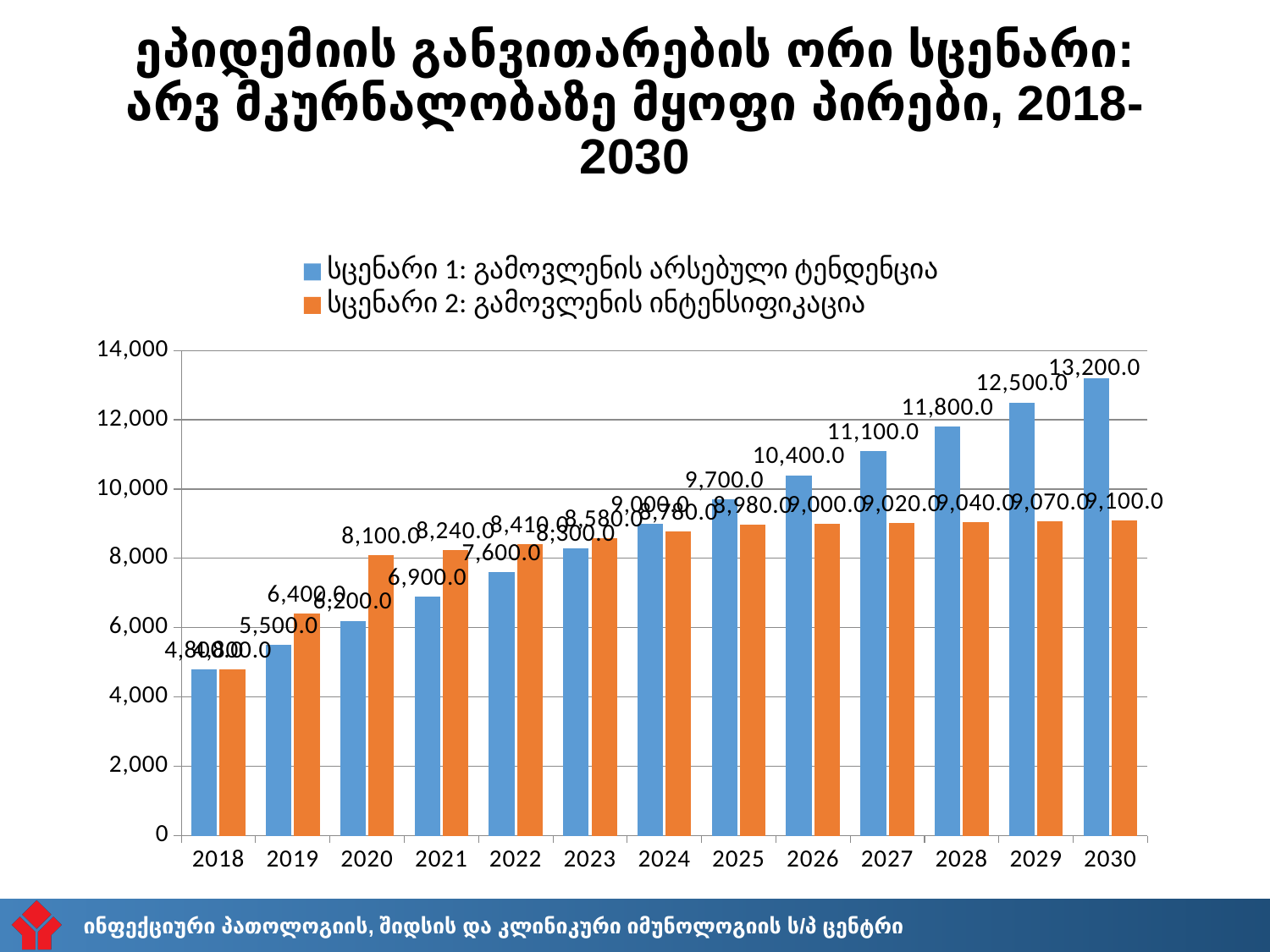
What type of chart is shown on the slide? bar chart Do the values for სცენარი 1 rise or fall from 2018 to 2030? rise How many years are shown on the x axis? 13 What is the value for სცენარი 2 (Scenario 2) in 2020? 8,100.0 Is the value for სცენარი 1 in 2028 greater or less than 10,000? greater How many series does the legend list? 2 In which year does სცენარი 1 (Scenario 1) reach its highest value? 2030 What is the value for სცენარი 1 (Scenario 1) in 2026? 10,400.0 What is the value for სცენარი 1 (Scenario 1) in 2030? 13,200.0 Which series has the larger value in 2020, სცენარი 1 or სცენარი 2? სცენარი 2 What is the difference between სცენარი 1 and სცენარი 2 in 2030? 4,100.0 What is the value for სცენარი 2 (Scenario 2) in 2030? 9,100.0